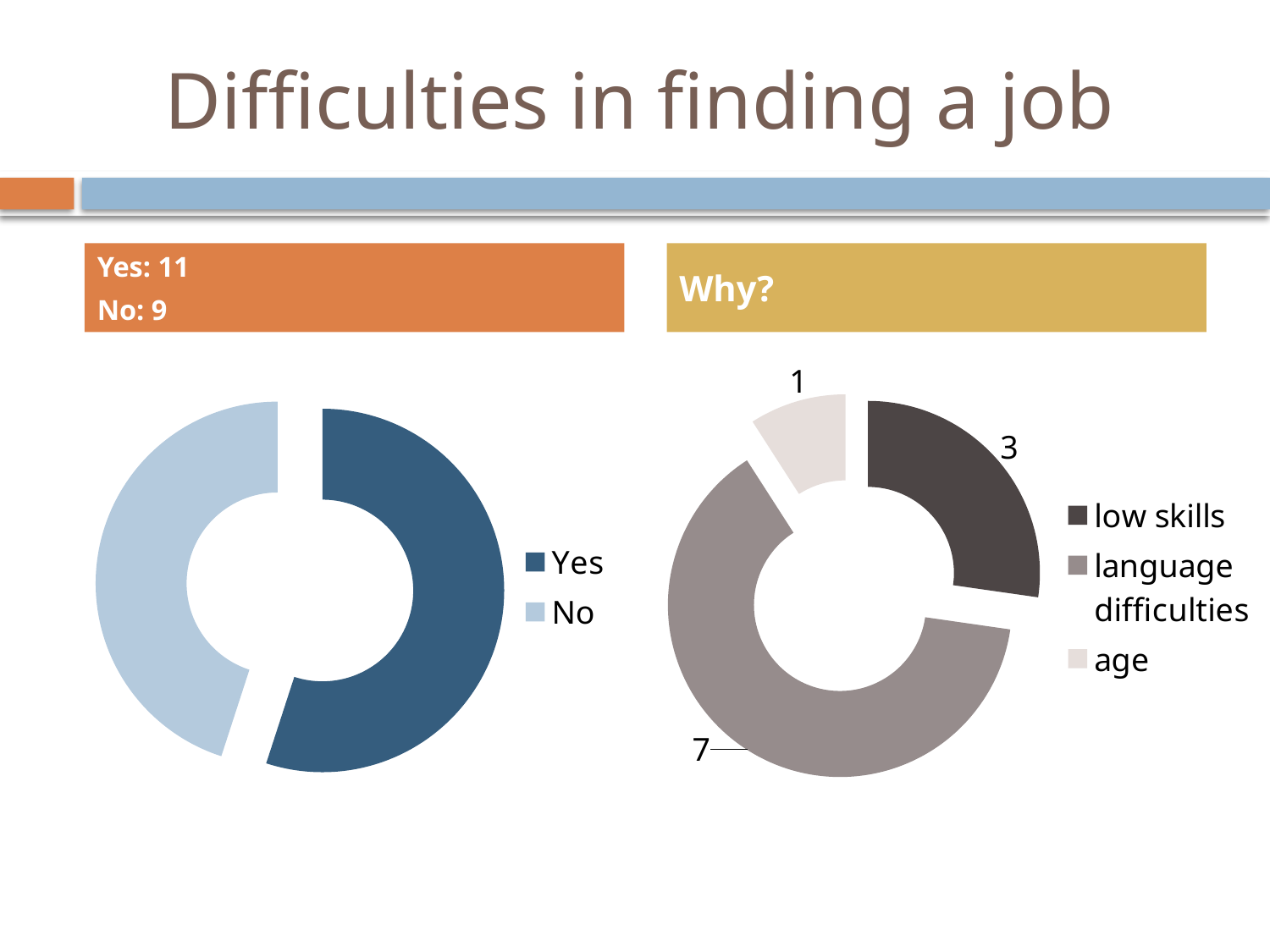
On the right-hand 'Why?' chart, which category has the lowest value? age On the right-hand 'Why?' chart, what is the value for language difficulties? 7 How many categories does the right-hand 'Why?' chart show? 3 On the left-hand Yes/No chart, how many people answered Yes according to the slide? 11 On the right-hand 'Why?' chart, what is the value for low skills? 3 On the right-hand 'Why?' chart, which is larger: low skills or age? low skills On the left-hand Yes/No chart, which segment is larger, Yes or No? Yes On the right-hand 'Why?' chart, which category has the highest value? language difficulties What are the legend entries of the right-hand 'Why?' chart? low skills, language difficulties, age On the right-hand 'Why?' chart, what is the difference between the values for language difficulties and low skills? 4 On the right-hand 'Why?' chart, what is the value for age? 1 What kind of chart is the left-hand Yes/No chart? doughnut chart